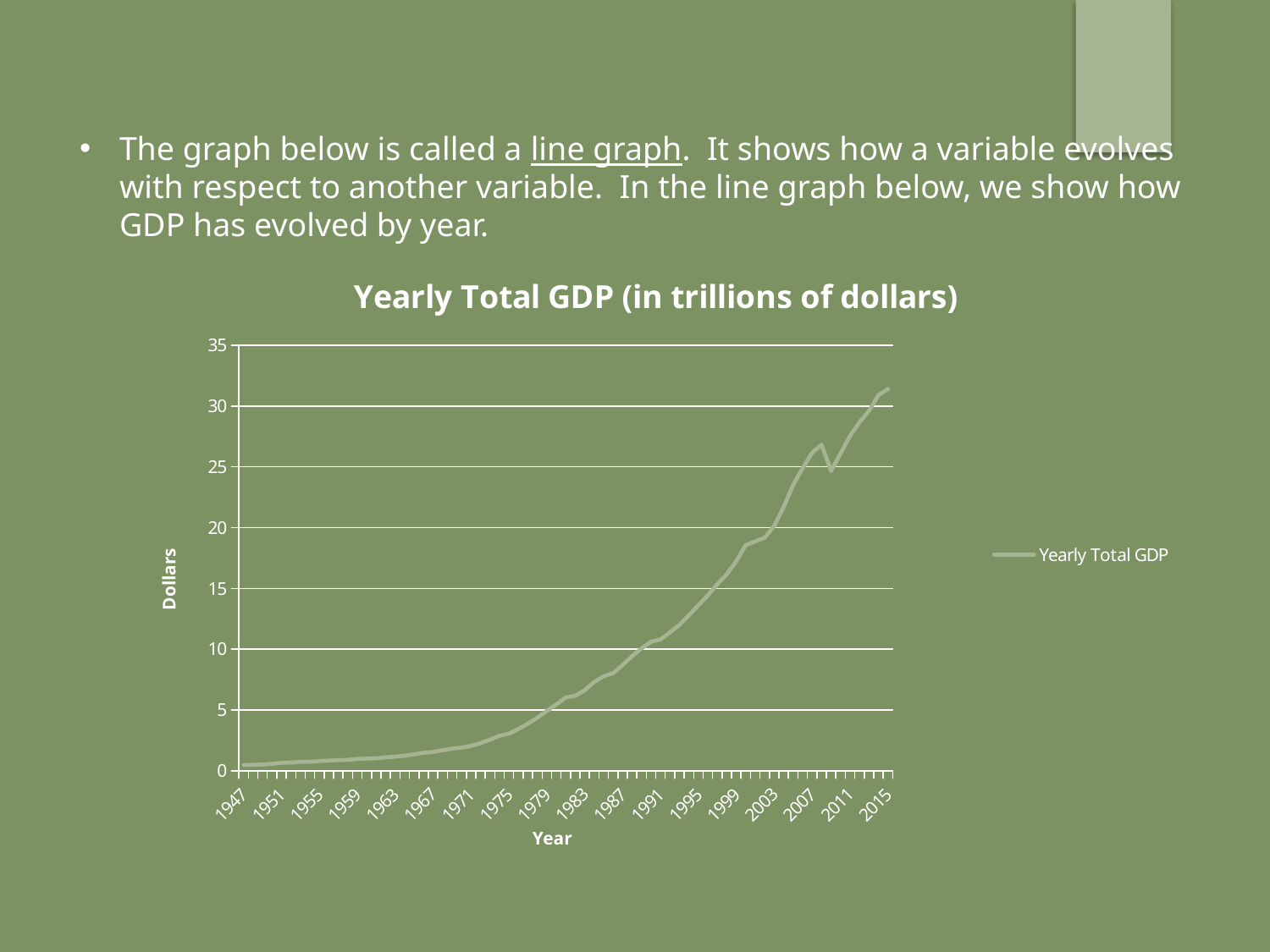
How many series does the legend list? 1 Is the value for 1947 greater or less than 5? less What is the label of the x axis? Year Is the value for 1971 greater or less than 5? less Which year has the highest Yearly Total GDP value? 2015 Is the value for 1995 greater or less than 10? greater Which year has the lowest Yearly Total GDP value? 1947 Which is larger, the value for 2011 or the value for 1983? 2011 What kind of chart is shown on the slide? line chart Do the values generally rise or fall from 1947 to 2015? rise What is the title of the chart? Yearly Total GDP (in trillions of dollars)